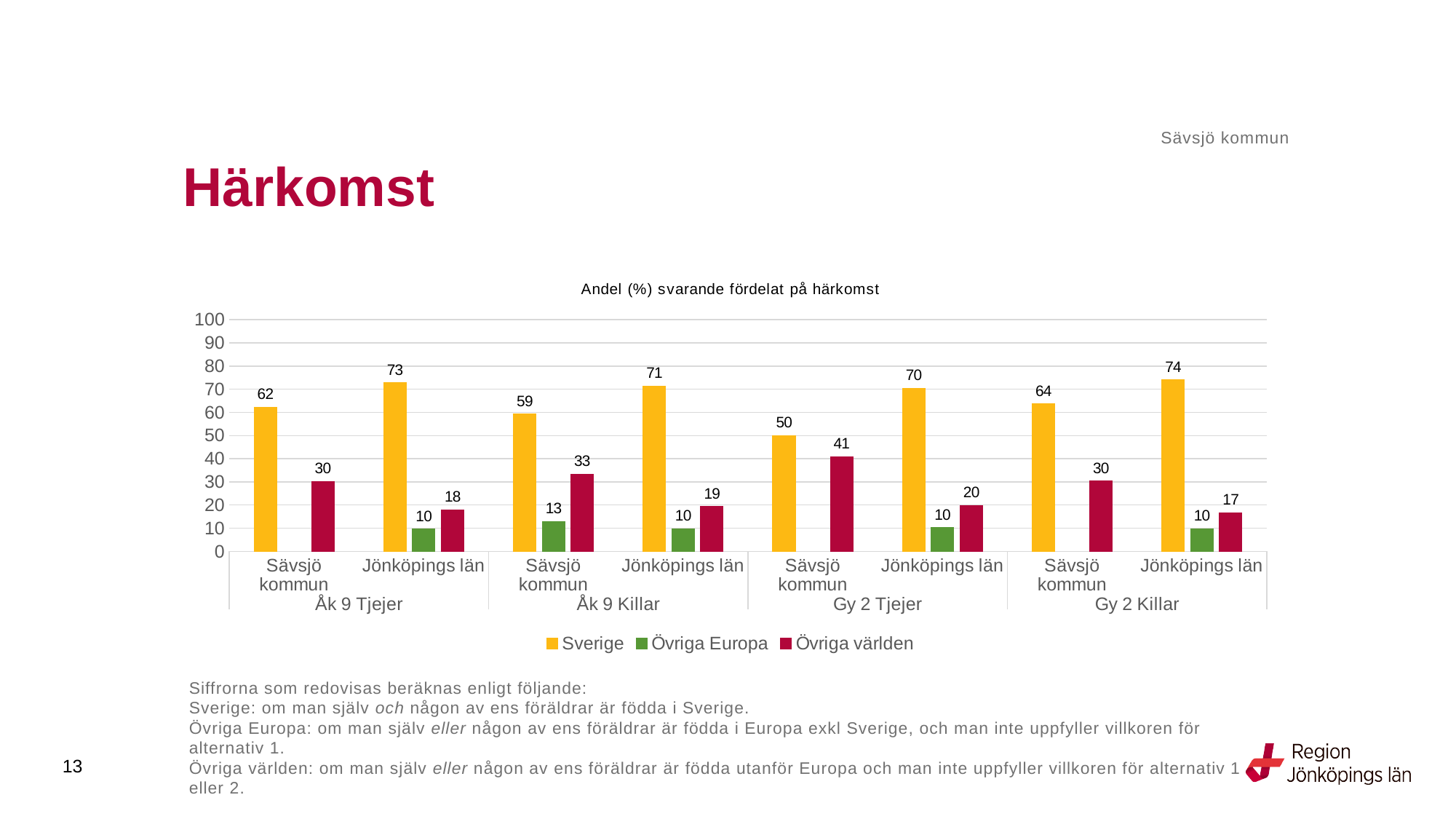
What is the Sverige value for Sävsjö kommun in the Åk 9 Tjejer group? 62 In the Åk 9 Killar group, which is larger: the Övriga världen value for Sävsjö kommun or for Jönköpings län? Sävsjö kommun Which group and area has the lowest Sverige value? Sävsjö kommun, Gy 2 Tjejer What is the Övriga världen value for Sävsjö kommun in the Gy 2 Tjejer group? 41 What is the difference between the Sverige values for Jönköpings län and Sävsjö kommun in the Gy 2 Tjejer group? 20 Which colour represents the Övriga Europa series? Green How many series does the legend list? 3 What kind of chart is shown on the slide? Bar chart What is the Sverige value for Jönköpings län in the Gy 2 Killar group? 74 Which group and area has the highest Sverige value? Jönköpings län, Gy 2 Killar What is the Övriga Europa value for Sävsjö kommun in the Åk 9 Killar group? 13 What is the title of the chart? Andel (%) svarande fördelat på härkomst